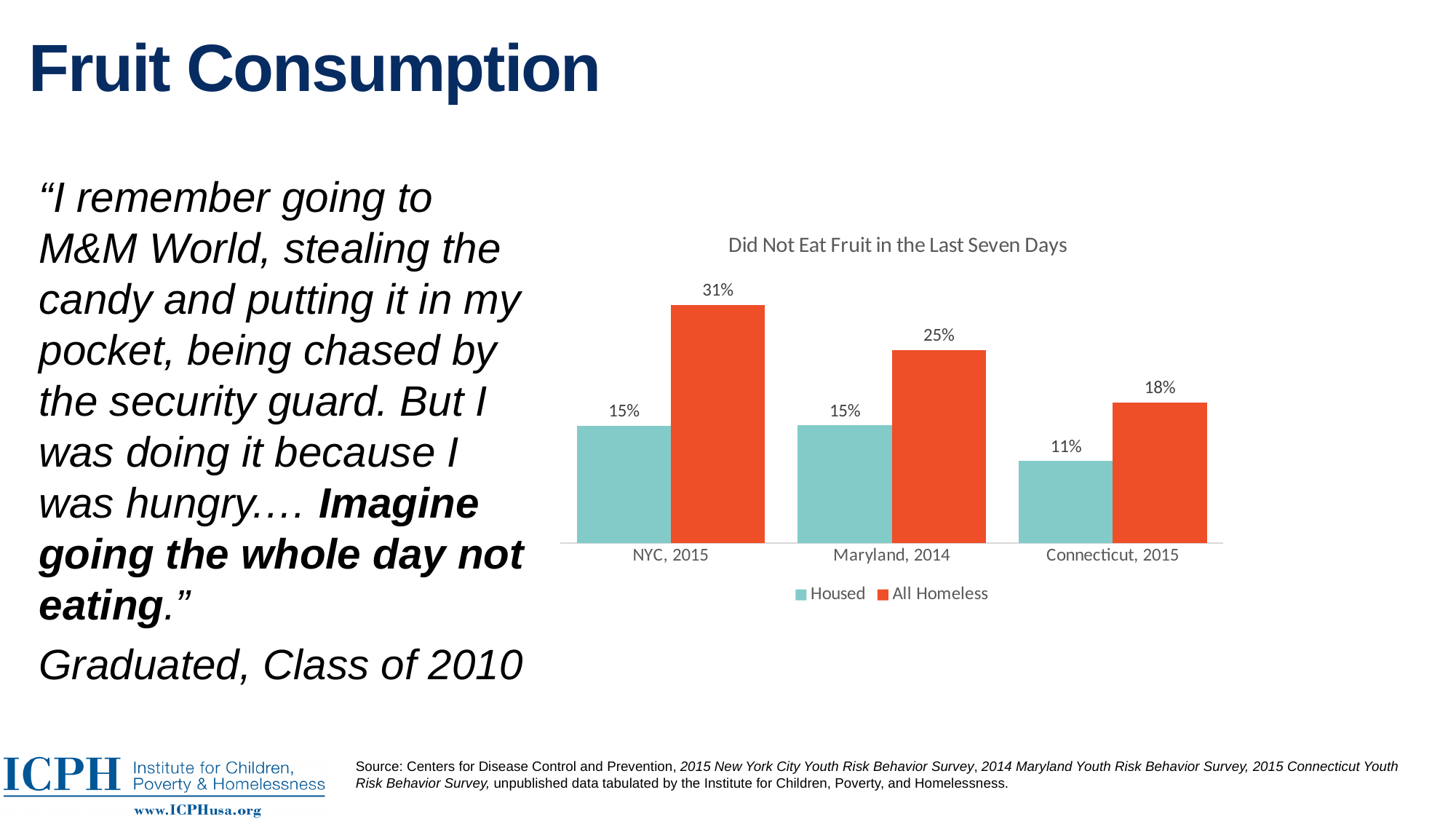
What kind of chart is shown on the slide? Bar chart Which category has the lowest Housed value? Connecticut, 2015 What is the value for All Homeless in Maryland, 2014? 25% What is the title of the chart? Did Not Eat Fruit in the Last Seven Days Which category has the highest All Homeless value? NYC, 2015 How many series does the legend list? 2 Which is larger: the All Homeless value for Connecticut, 2015 or the Housed value for NYC, 2015? All Homeless value for Connecticut, 2015 How many categories are shown on the x axis? 3 What is the difference between the All Homeless values for Maryland, 2014 and Connecticut, 2015? 7% What is the value for All Homeless in NYC, 2015? 31% What is the value for Housed in Connecticut, 2015? 11% What is the difference between the All Homeless and Housed values for NYC, 2015? 16%